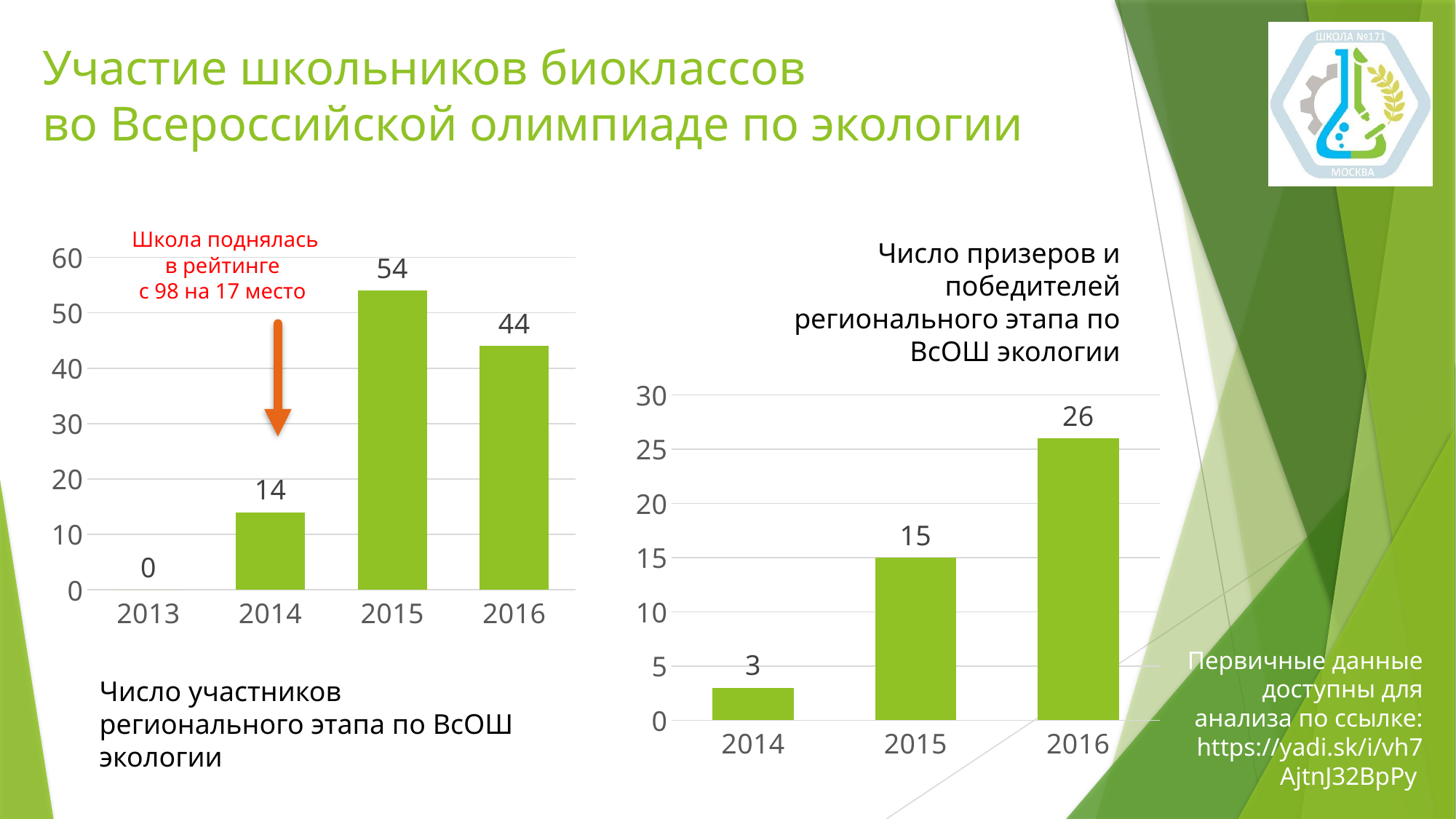
In the left chart (number of participants of the regional stage), what is the value for 2014? 14 In the left chart (number of participants of the regional stage), which year has the highest value? 2015 In the right chart (number of prize-winners and winners of the regional stage), what is the value for 2016? 26 In the right chart (number of prize-winners and winners of the regional stage), what is the value for 2014? 3 In the right chart (number of prize-winners and winners of the regional stage), what is the difference between the values for 2016 and 2015? 11 In the left chart (number of participants of the regional stage), how many years are shown on the x axis? 4 In the left chart (number of participants of the regional stage), which year has the lowest value? 2013 In the left chart (number of participants of the regional stage), what is the difference between the values for 2015 and 2016? 10 In the right chart (number of prize-winners and winners of the regional stage), do the values rise or fall from 2014 to 2016? rise In the left chart (number of participants of the regional stage), what is the value for 2015? 54 In the right chart (number of prize-winners and winners of the regional stage), which is larger, the value for 2015 or 2016? 2016 What kind of chart is the right chart (number of prize-winners and winners of the regional stage)? bar chart